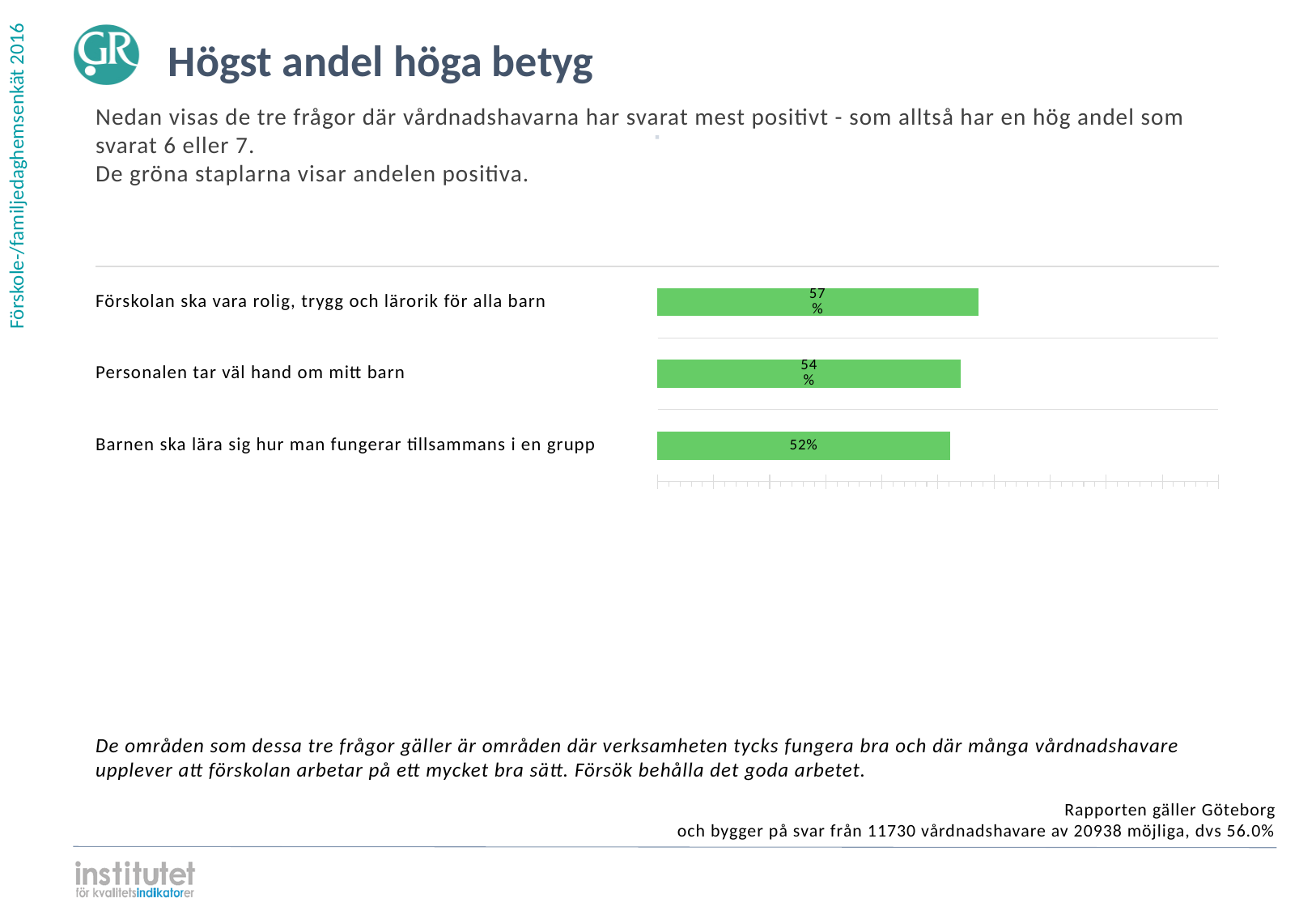
Which has a higher value: "Personalen tar väl hand om mitt barn" or "Barnen ska lära sig hur man fungerar tillsammans i en grupp"? Personalen tar väl hand om mitt barn What percentage is shown for "Förskolan ska vara rolig, trygg och lärorik för alla barn"? 57% What percentage is shown for "Barnen ska lära sig hur man fungerar tillsammans i en grupp"? 52% Which question has the lowest share of positive answers? Barnen ska lära sig hur man fungerar tillsammans i en grupp What is the title of the slide containing the chart? Högst andel höga betyg What is the difference in percentage points between "Personalen tar väl hand om mitt barn" and "Barnen ska lära sig hur man fungerar tillsammans i en grupp"? 2 percentage points What percentage is shown for "Personalen tar väl hand om mitt barn"? 54% Which question has the highest share of positive answers? Förskolan ska vara rolig, trygg och lärorik för alla barn What kind of chart is shown on the slide? Bar chart What is the difference in percentage points between "Förskolan ska vara rolig, trygg och lärorik för alla barn" and "Barnen ska lära sig hur man fungerar tillsammans i en grupp"? 5 percentage points How many questions (categories) are shown in the chart? 3 What colour are the bars in the chart? Green